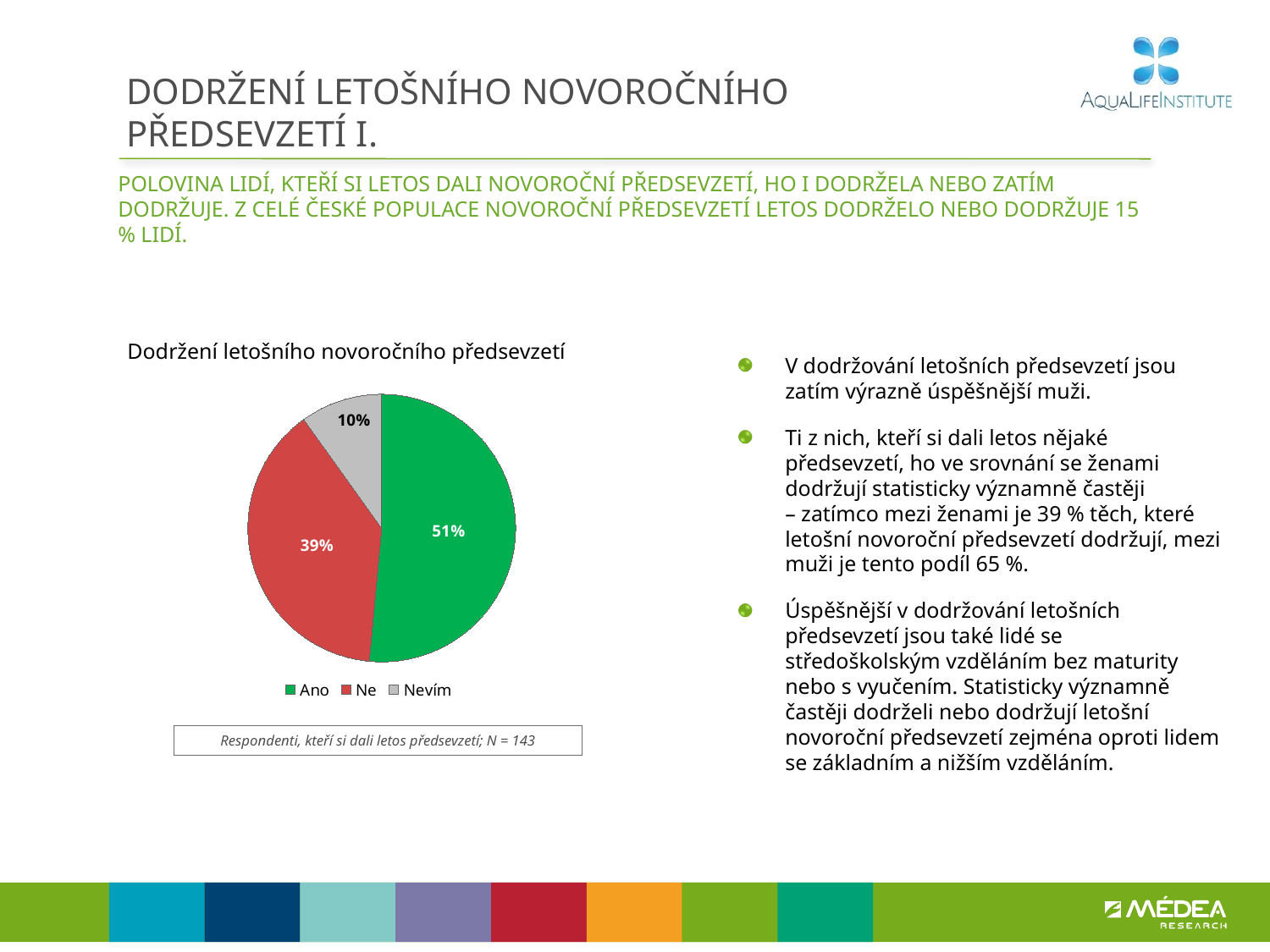
What share of respondents answered "Ano" in the pie chart? 51% What share of respondents answered "Ne" in the pie chart? 39% Which slice is larger, "Ne" or "Nevím"? Ne Is the share for "Ne" greater or less than 50%? less What share of respondents answered "Nevím" in the pie chart? 10% What is the title of the chart? Dodržení letošního novoročního předsevzetí What type of chart is shown on the slide? Pie chart What colour is the "Ano" slice in the pie chart? Green What is the difference in percentage points between the "Ano" and "Ne" slices? 12 Which category has the smallest slice of the pie chart? Nevím Which category has the largest slice of the pie chart? Ano How many categories does the pie chart show? 3